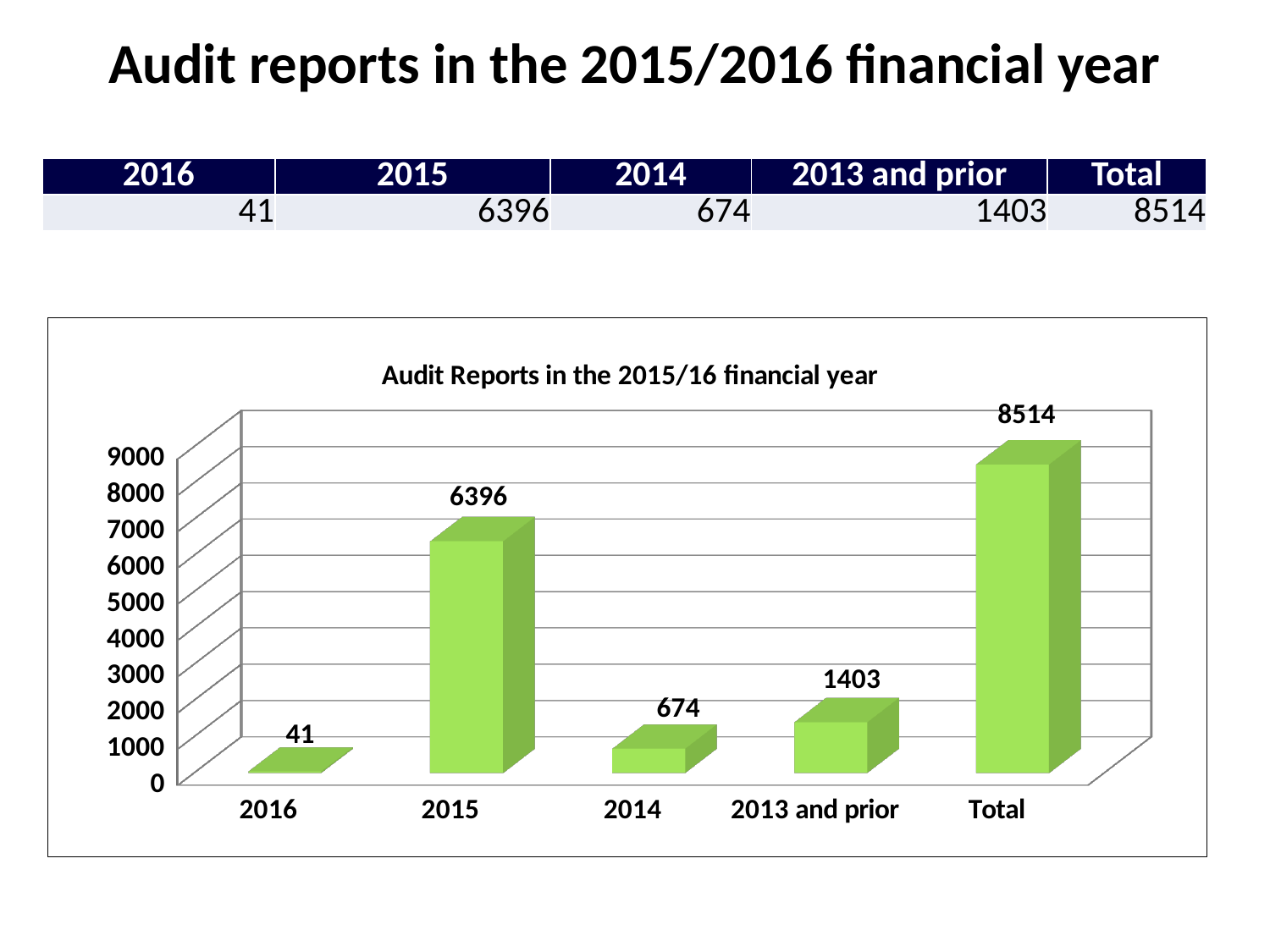
Which category has the lowest value in the chart? 2016 What is the value for 2014 in the chart? 674 How many categories are shown on the x axis of the chart? 5 Which is larger, the value for 2014 or the value for 2013 and prior? 2013 and prior Which category has the highest value in the chart? Total What is the value for 2015 in the chart? 6396 What is the value for 2013 and prior in the chart? 1403 What is the value for 2016 in the chart? 41 What is the difference between the values for 2015 and 2014? 5722 What kind of chart is shown on the slide? bar chart What is the title of the chart? Audit Reports in the 2015/16 financial year Is the value for 2015 greater or less than 6000? greater